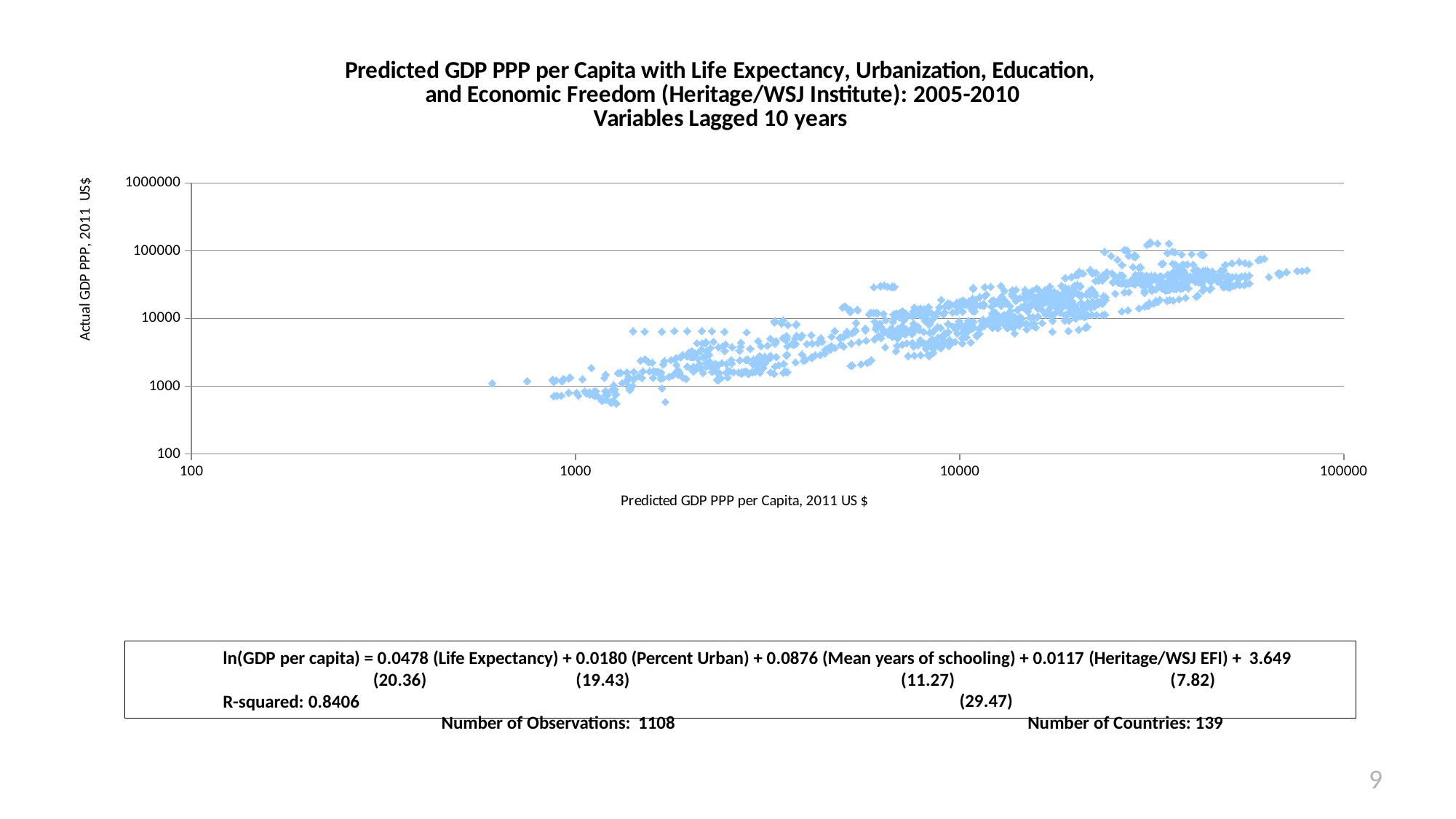
Do the plotted values of actual GDP PPP per capita generally rise or fall as predicted GDP PPP per capita increases along the x axis? Rise What is the title of the x axis of the chart? Predicted GDP PPP per Capita, 2011 US $ What is the highest tick value shown on the y axis of the chart? 1000000 What kind of chart is shown on the slide? Scatter chart